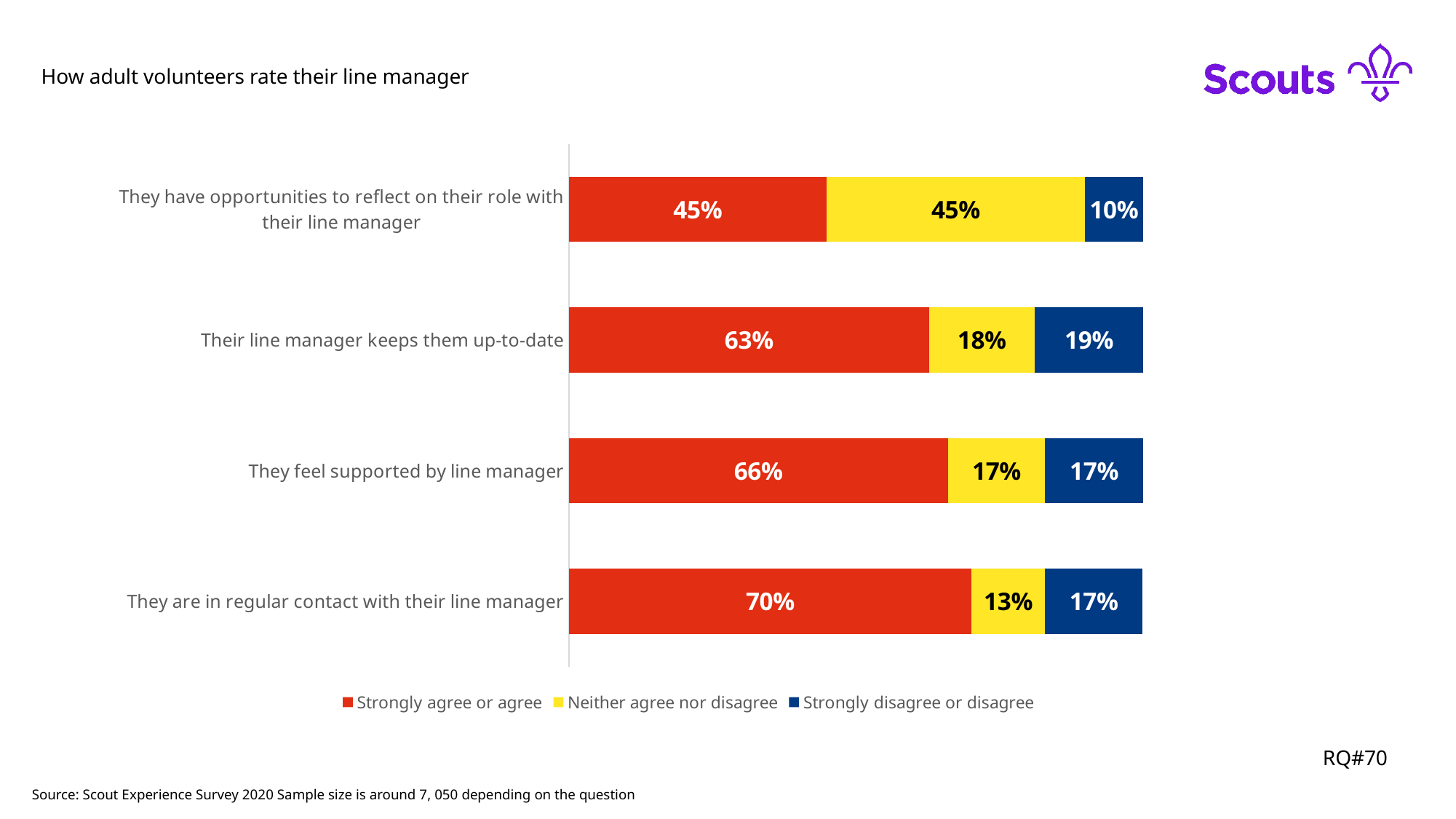
What percentage strongly disagree or disagree that their line manager keeps them up-to-date? 19% What percentage of adult volunteers strongly agree or agree that they are in regular contact with their line manager? 70% What percentage strongly agree or agree that they feel supported by line manager? 66% How many statements are shown in the chart? 4 What is the difference between the 'Strongly agree or agree' percentages for 'They are in regular contact with their line manager' and 'Their line manager keeps them up-to-date'? 7% Which statement has the highest 'Strongly agree or agree' percentage? They are in regular contact with their line manager Which statement has the lowest 'Strongly agree or agree' percentage? They have opportunities to reflect on their role with their line manager What percentage neither agree nor disagree that they have opportunities to reflect on their role with their line manager? 45% What kind of chart is shown on the slide? Stacked bar chart Which colour represents 'Strongly disagree or disagree' in the chart? Blue How many series does the legend list? 3 Which is larger: the 'Neither agree nor disagree' share for 'Their line manager keeps them up-to-date' or for 'They are in regular contact with their line manager'? Their line manager keeps them up-to-date